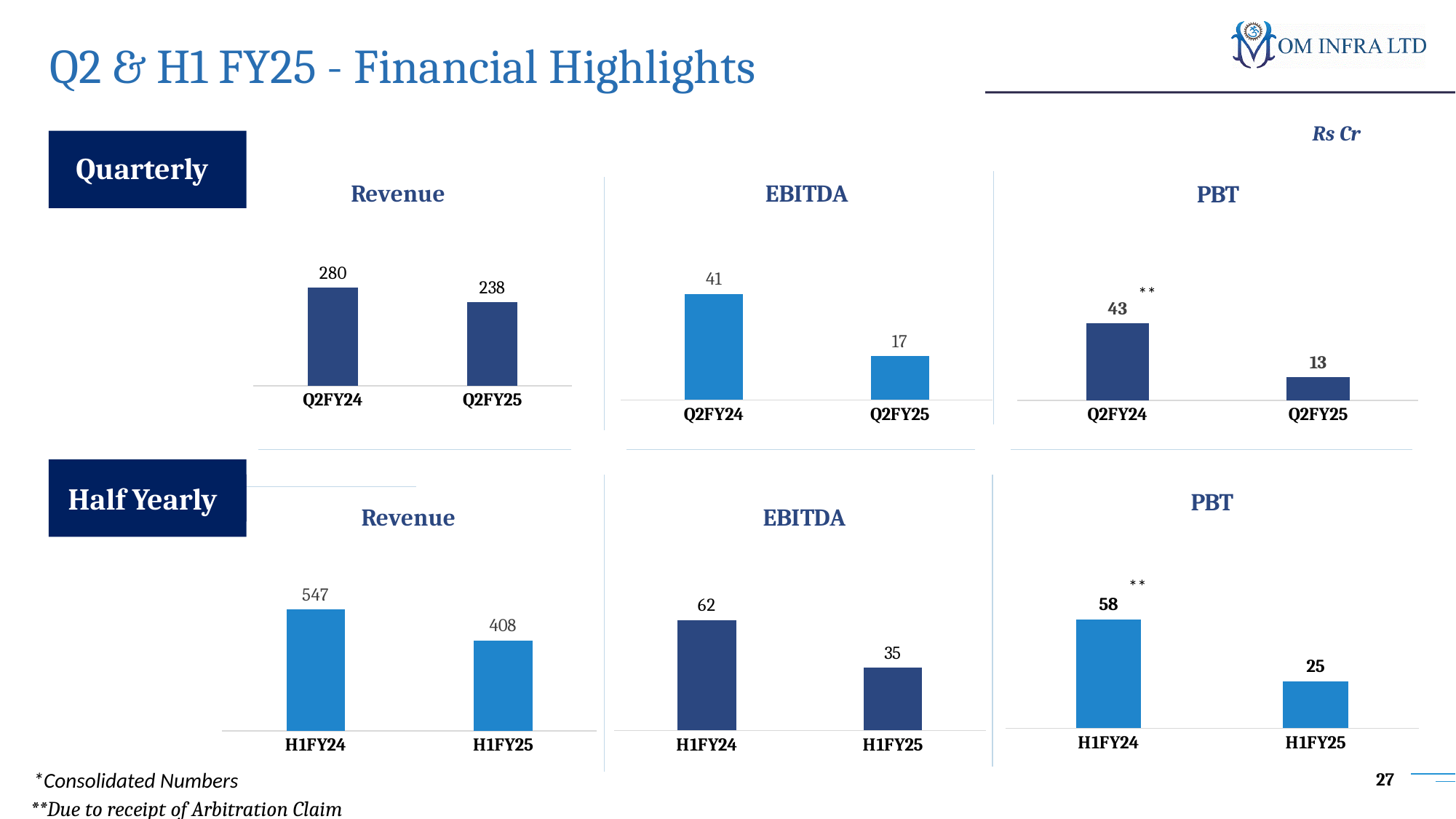
In the Quarterly Revenue chart, what is the difference between Q2FY24 and Q2FY25? 42 In the Quarterly Revenue chart, what is the value for Q2FY24? 280 In the Half Yearly PBT chart, do the values rise or fall from H1FY24 to H1FY25? fall What kind of chart is the Quarterly PBT chart? bar chart How many bars are in the Half Yearly EBITDA chart? 2 In the Half Yearly EBITDA chart, what is the value for H1FY24? 62 In the Half Yearly Revenue chart, what is the value for H1FY25? 408 In the Quarterly EBITDA chart, what is the value for Q2FY25? 17 In the Quarterly EBITDA chart, which period has the higher value, Q2FY24 or Q2FY25? Q2FY24 In the Half Yearly PBT chart, what is the value for H1FY25? 25 In the Half Yearly Revenue chart, what is the difference between H1FY24 and H1FY25? 139 In the Quarterly PBT chart, what is the value for Q2FY24? 43